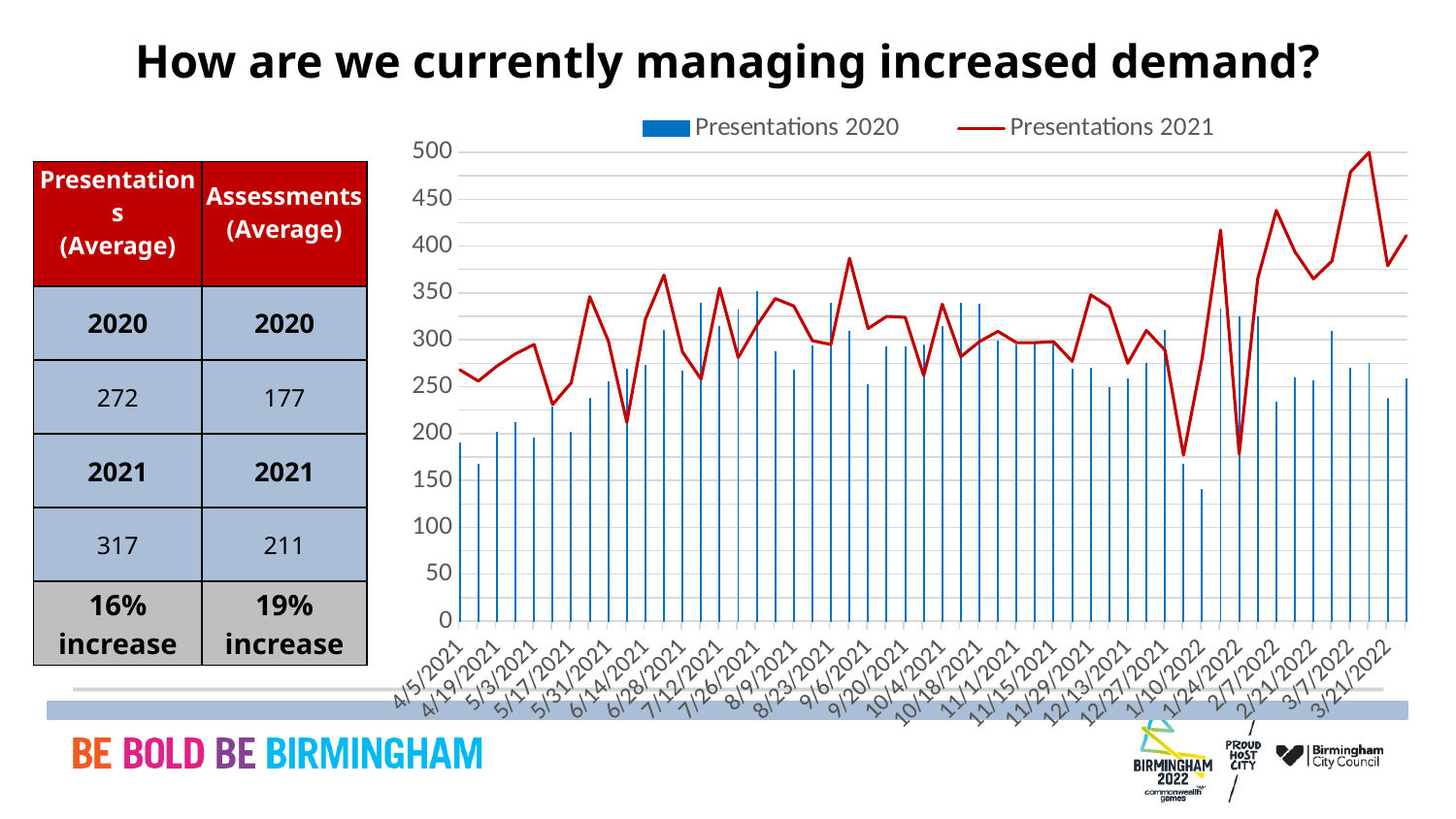
Is the Presentations 2020 value at 4/5/2021 greater or less than 250? less What kind of chart is used to show the Presentations 2020 series? Bar chart Does the Presentations 2021 line rise or fall between 1/10/2022 and 3/7/2022? Rise Is the Presentations 2020 value at 1/10/2022 greater or less than 200? less What colour is the Presentations 2021 line? Red Is the Presentations 2021 value at 1/10/2022 greater or less than 250? greater How many series does the chart legend list? 2 What is the first date label on the x axis of the chart? 4/5/2021 At 3/7/2022, which series has the larger value, Presentations 2020 or Presentations 2021? Presentations 2021 What is the highest value shown on the vertical axis of the chart? 500 What kind of chart is used to show the Presentations 2021 series? Line chart